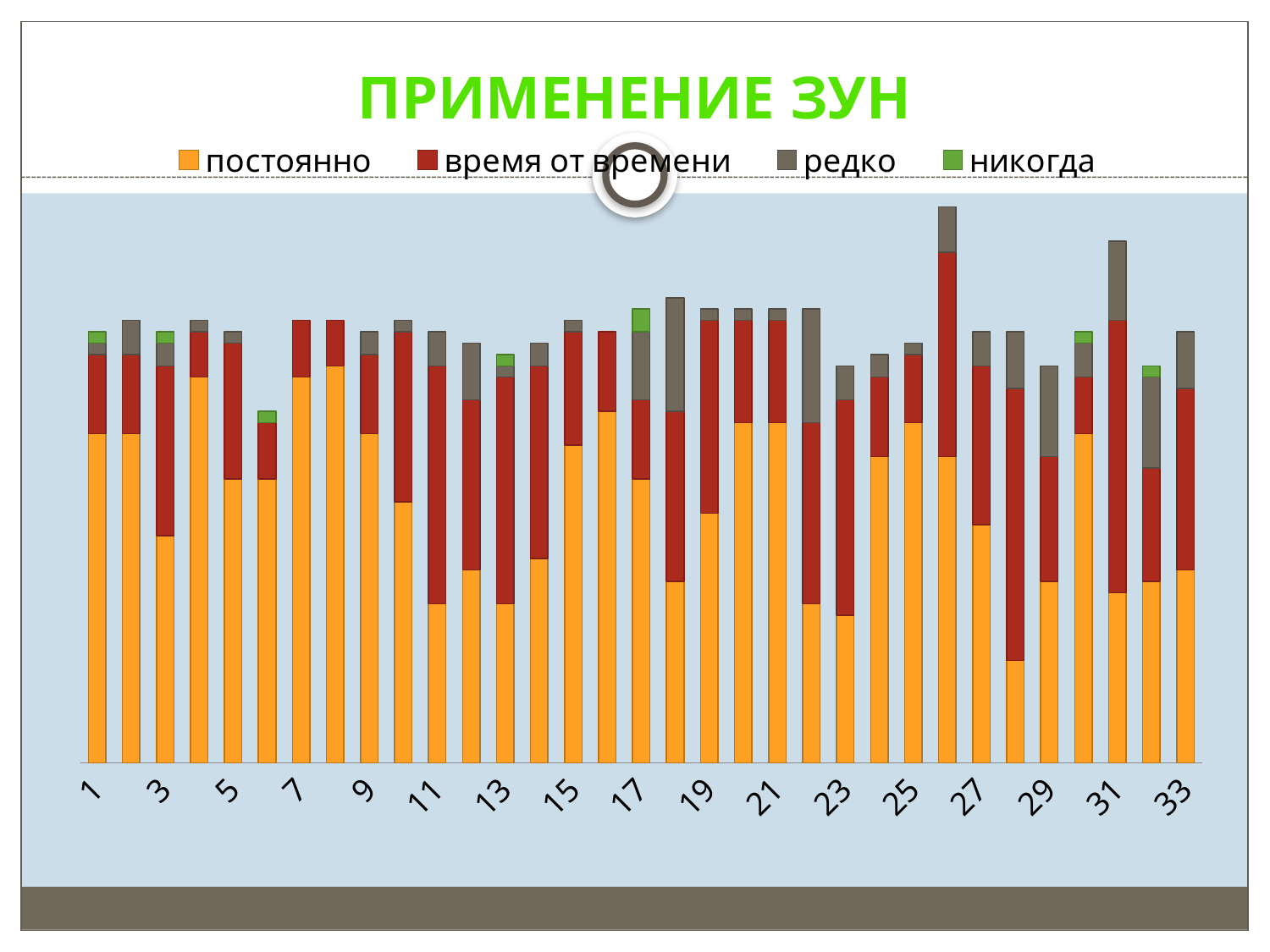
Which bar is taller in total, bar 31 or bar 1? 31 Which bar has the smallest total height? 6 Which series forms the bottom segment of each stacked bar? постоянно How many bars (categories) are plotted along the x axis? 33 What kind of chart is shown on the slide? Stacked bar chart Which bar is taller in total, bar 26 or bar 6? 26 How many series does the legend list? 4 Which series is shown in green in the legend? никогда Which bar has the smallest 'постоянно' (orange) segment? 28 Which bar has the greatest total height? 26 What is the title of the chart? ПРИМЕНЕНИЕ ЗУН